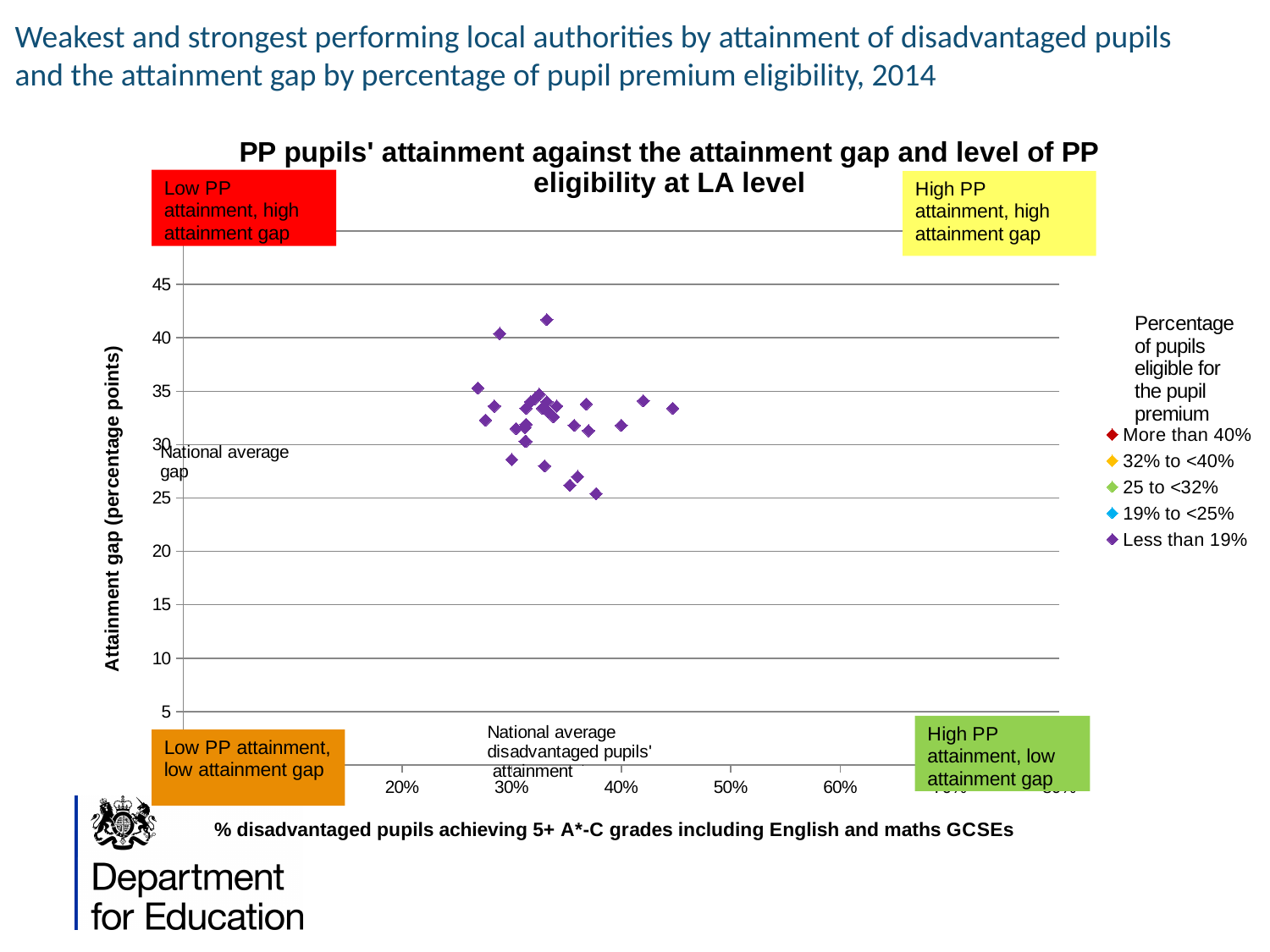
What is the title of the chart? PP pupils' attainment against the attainment gap and level of PP eligibility at LA level Are all the plotted points' attainment gaps greater or less than 20? greater Is the lowest attainment gap plotted on the chart greater or less than 30? less What kind of chart is shown on the slide? Scatter chart Is the highest attainment gap plotted on the chart greater or less than 40? greater What is the label of the chart's vertical axis? Attainment gap (percentage points) How many series does the chart's legend list? 5